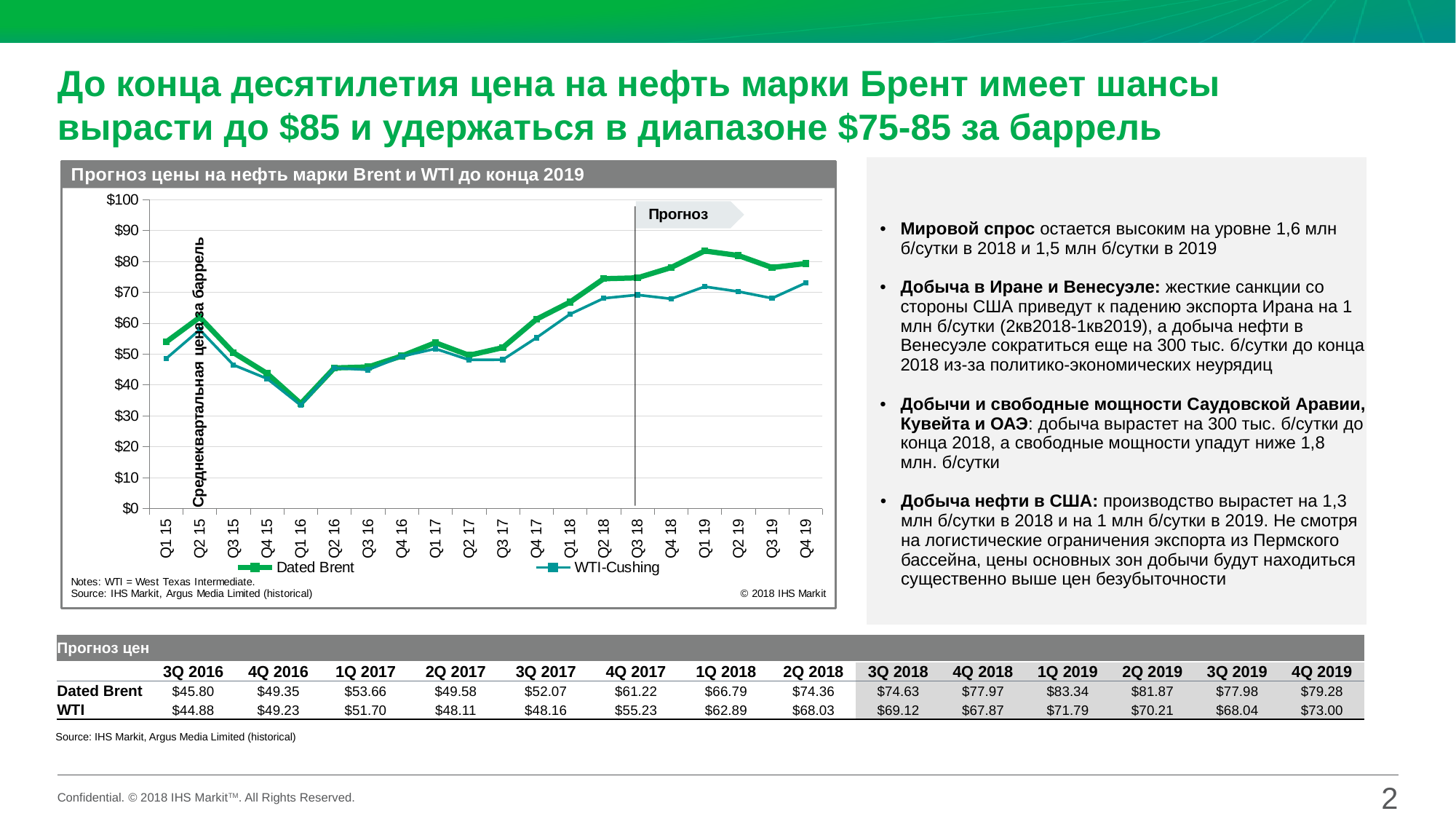
What is the difference between the Dated Brent and WTI prices in 1Q 2019? $11.55 In Q1 19, which series is higher: Dated Brent or WTI-Cushing? Dated Brent In which quarter does Dated Brent reach its lowest point on the chart? Q1 16 How many series does the chart legend list? 2 What kind of chart is shown on the slide? Line chart Is the Dated Brent value for Q1 19 greater or less than $80? greater Does the Dated Brent line rise or fall from Q1 16 to Q1 19? Rise According to the slide, what is the WTI price for 4Q 2019? $73.00 What is the title of the chart? Прогноз цены на нефть марки Brent и WTI до конца 2019 According to the slide, what is the Dated Brent price for 1Q 2019? $83.34 Is the Dated Brent value for Q1 16 greater or less than $40? less How many quarters are plotted along the x axis of the chart? 20